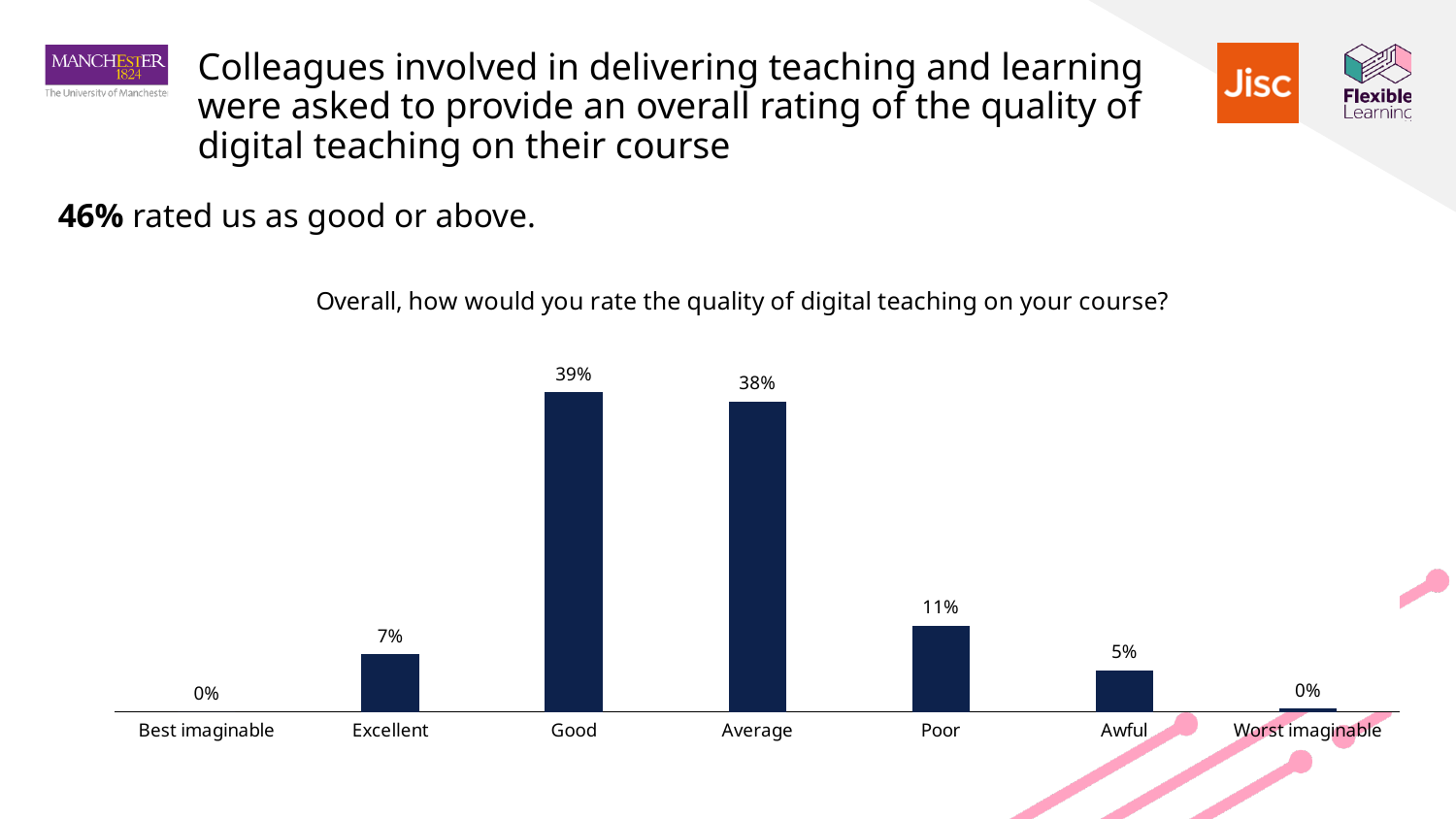
What percentage of respondents rated the quality of digital teaching as Excellent? 7% What percentage of respondents rated the quality of digital teaching as Awful? 5% Which has a higher percentage, Excellent or Poor? Poor What percentage of respondents rated the quality of digital teaching as Good? 39% Which rating category has the highest percentage of respondents? Good What is the difference in percentage points between the Poor and Awful ratings? 6% What is the title of the chart? Overall, how would you rate the quality of digital teaching on your course? What is the difference in percentage points between the Good and Average ratings? 1% How many rating categories are shown on the x axis of the chart? 7 What percentage of respondents rated the quality of digital teaching as Poor? 11% What is the combined percentage of respondents who rated digital teaching as Excellent or Good? 46% What type of chart is used to show the ratings of digital teaching quality? Bar chart